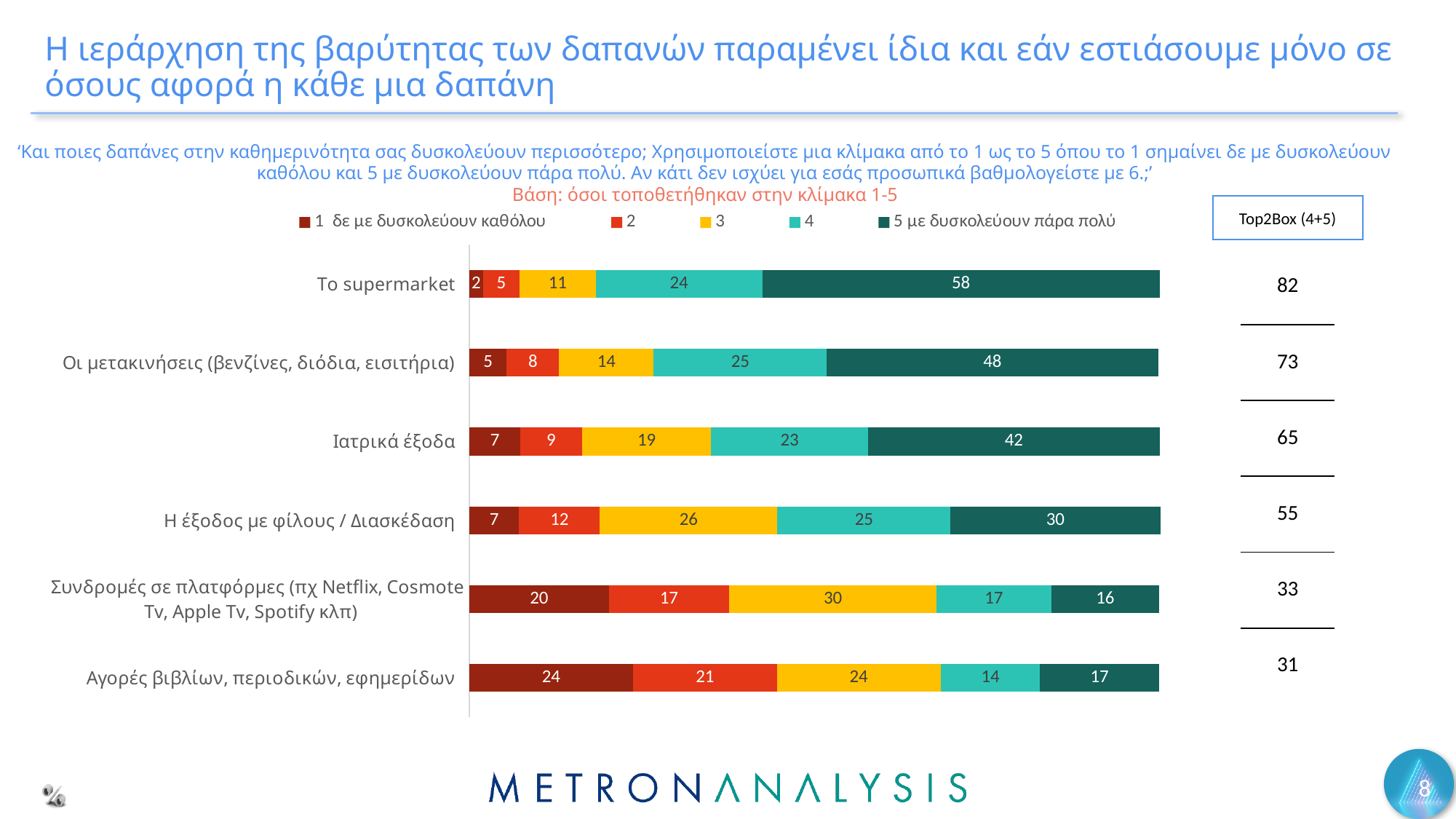
How many series does the legend list? 5 How many categories are shown in the chart? 6 What is the difference between the '5 με δυσκολεύουν πάρα πολύ' values for 'Το supermarket' and 'Ιατρικά έξοδα'? 16 Which category has the lowest Top2Box (4+5) value? Αγορές βιβλίων, περιοδικών, εφημερίδων Which is larger: the '4' segment for 'Οι μετακινήσεις (βενζίνες, διόδια, εισιτήρια)' or the '4' segment for 'Αγορές βιβλίων, περιοδικών, εφημερίδων'? Οι μετακινήσεις (βενζίνες, διόδια, εισιτήρια) What is the value of the '3' segment for 'Συνδρομές σε πλατφόρμες (πχ Netflix, Cosmote Tv, Apple Tv, Spotify κλπ)'? 30 What is the value of the '1 δε με δυσκολεύουν καθόλου' segment for 'Αγορές βιβλίων, περιοδικών, εφημερίδων'? 24 What is the value of the '5 με δυσκολεύουν πάρα πολύ' segment for 'Το supermarket'? 58 Which category has the highest value for the '5 με δυσκολεύουν πάρα πολύ' segment? Το supermarket What kind of chart is shown on the slide? Stacked bar chart What is the total of the stacked bar for 'Η έξοδος με φίλους / Διασκέδαση'? 100 What is the Top2Box (4+5) value shown for 'Οι μετακινήσεις (βενζίνες, διόδια, εισιτήρια)'? 73